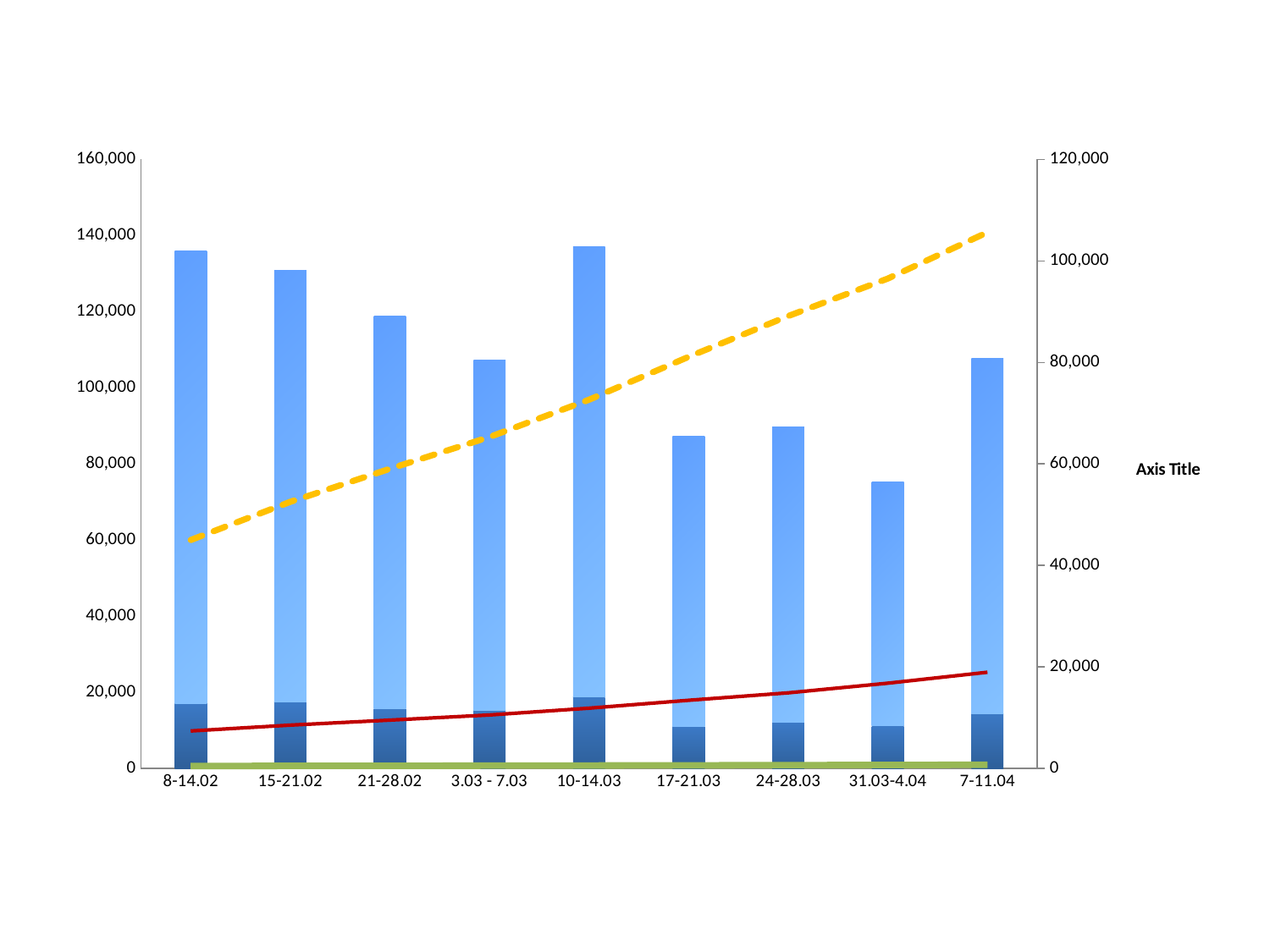
Does the yellow dashed line rise or fall from left to right across the x axis? rises How many categories are shown on the x axis of the chart? 9 Is the light blue bar for 8-14.02 greater or less than 120,000 on the left axis? greater Which category has the lowest light blue bar? 31.03-4.04 Which light blue bar is taller, 8-14.02 or 17-21.03? 8-14.02 Is the light blue bar for 17-21.03 greater or less than 100,000 on the left axis? less What is the title shown on the right-hand axis? Axis Title Is the light blue bar for 31.03-4.04 greater or less than 80,000 on the left axis? less What is the highest tick value shown on the left axis? 160,000 What kind of chart is shown on the slide? combination bar and line chart Which light blue bar is taller, 24-28.03 or 10-14.03? 10-14.03